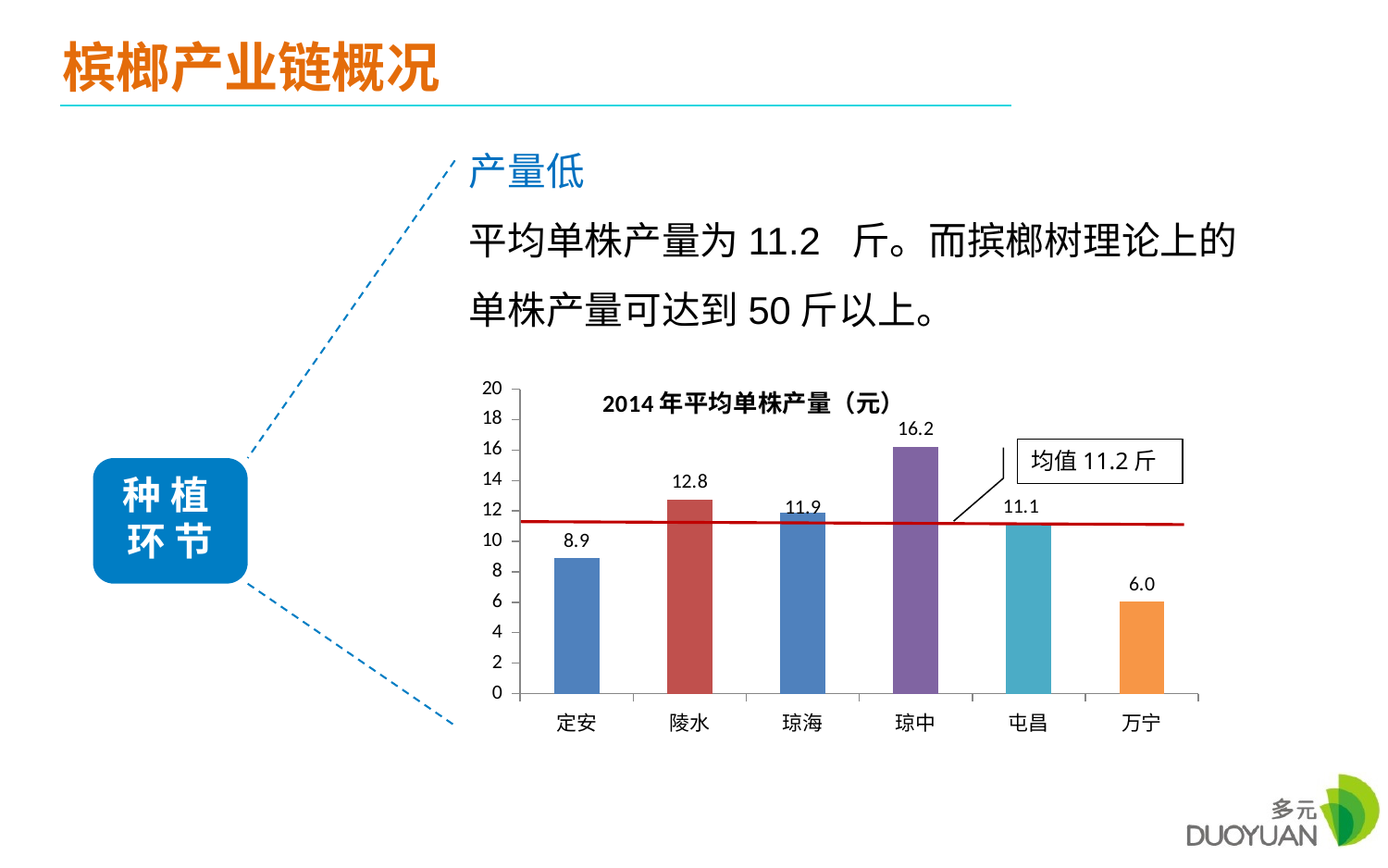
What is the title of the chart? 2014 年平均单株产量（元） Which category has the lowest value? 万宁 What is the value for 陵水? 12.8 How many categories are shown on the x axis? 6 What is the difference between the values for 琼中 and 万宁? 10.2 What is the value for 定安? 8.9 Which is larger, the value for 陵水 or the value for 屯昌? 陵水 Which category has the highest value? 琼中 What is the value for 琼中? 16.2 What kind of chart is this? bar chart Is the value for 琼海 greater or less than 10? greater What is the value for 万宁? 6.0